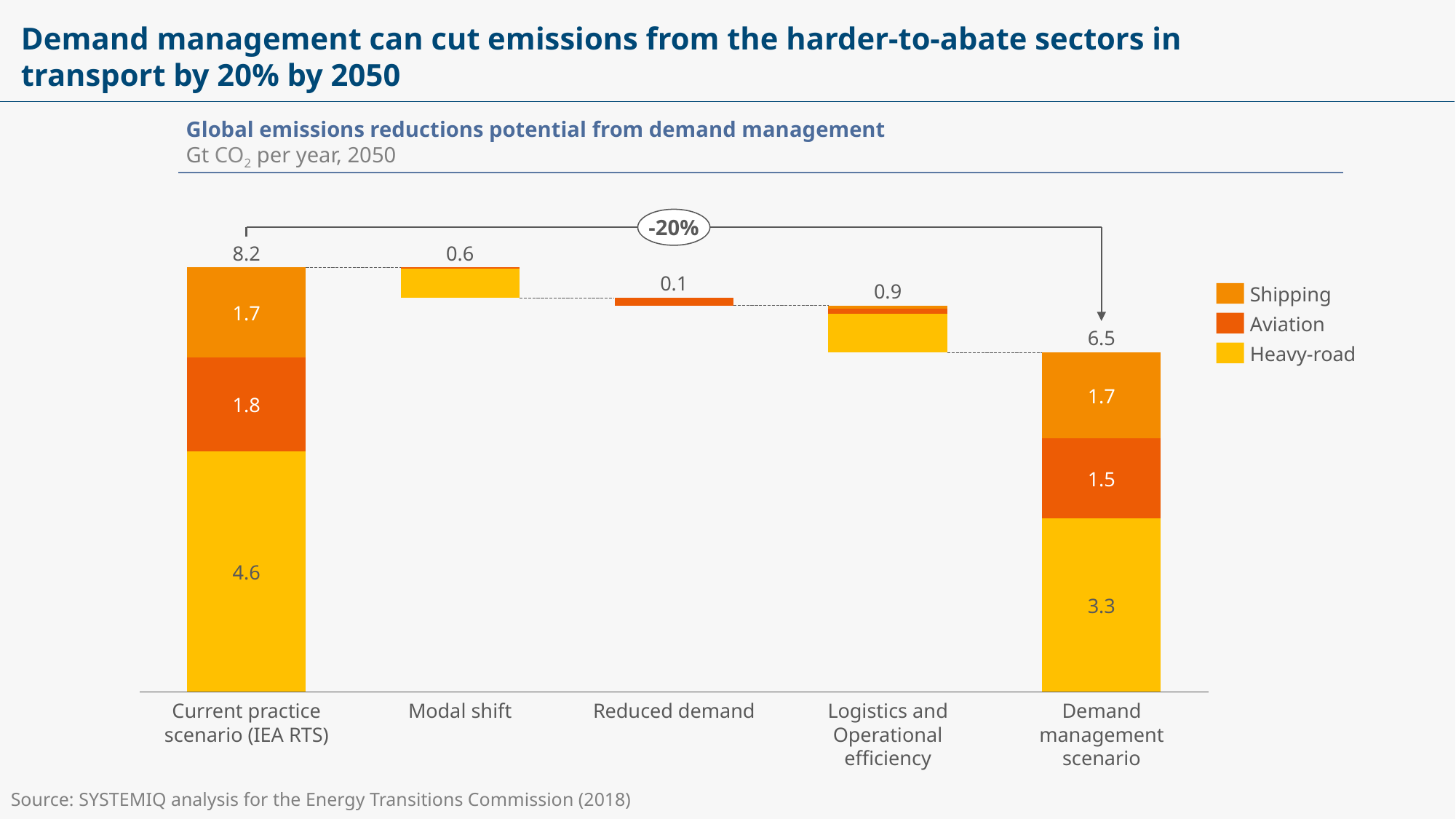
Which of the three reduction steps (Modal shift, Reduced demand, Logistics and Operational efficiency) has the smallest value? Reduced demand What value is shown for Modal shift? 0.6 How many series does the legend list? 3 What is the total value for the Current practice scenario (IEA RTS) bar? 8.2 What is the Aviation value in the Current practice scenario (IEA RTS) bar? 1.8 What kind of chart is shown on the slide? Bar chart Which is larger, the value for Modal shift or the value for Logistics and Operational efficiency? Logistics and Operational efficiency By how much does the Aviation value fall from the Current practice scenario to the Demand management scenario? 0.3 How many categories are shown along the x axis? 5 What percentage change is shown in the oval above the chart between the Current practice scenario and the Demand management scenario? -20% What is the difference between the Heavy-road value in the Current practice scenario and the Heavy-road value in the Demand management scenario? 1.3 What is the Heavy-road value in the Demand management scenario bar? 3.3